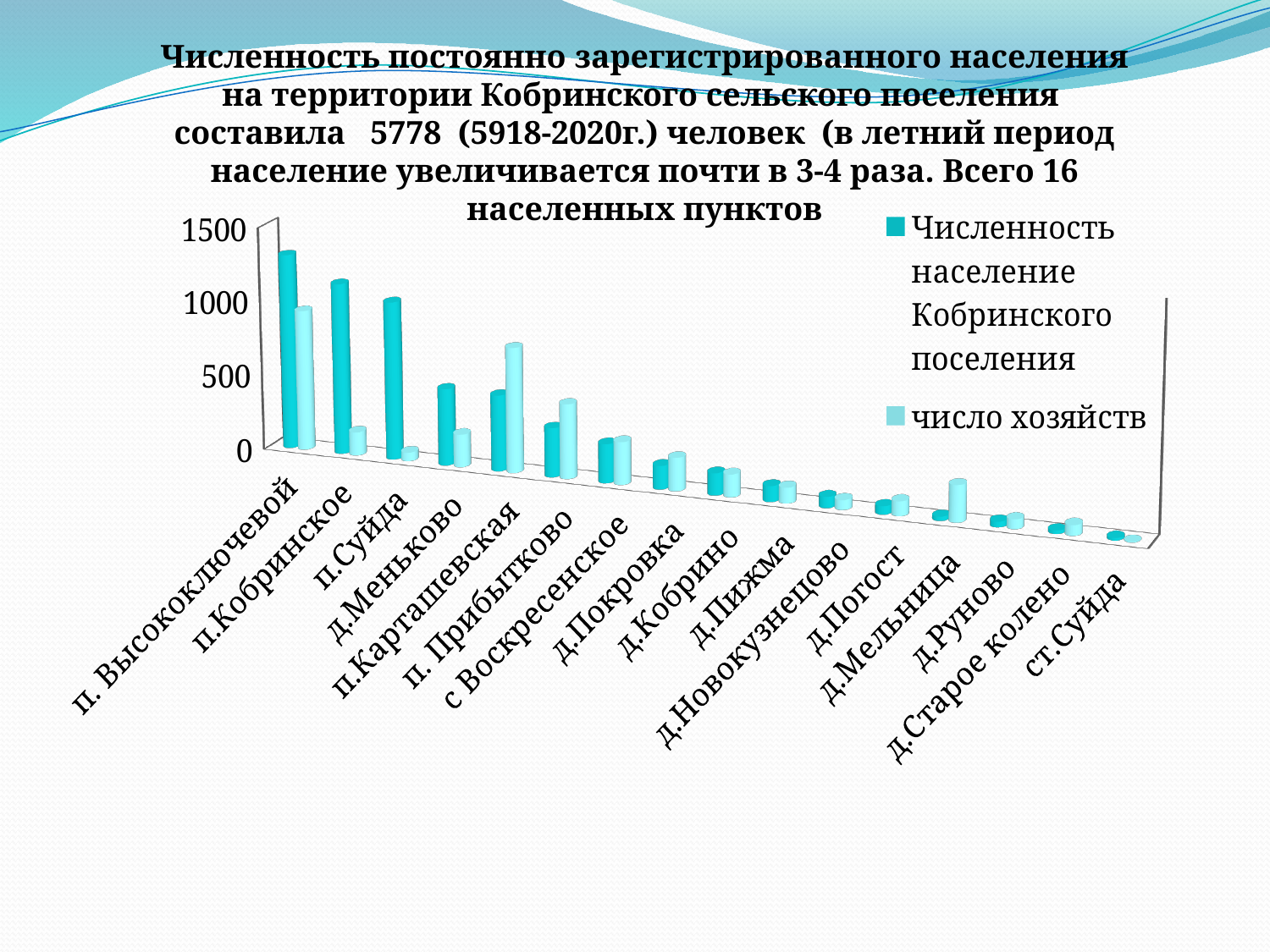
For п.Карташевская, which is larger: Численность население Кобринского поселения or число хозяйств? число хозяйств Which settlement has the highest value for число хозяйств? п. Высокоключевой Do the values of Численность население Кобринского поселения generally rise or fall from left to right along the x axis? fall Is the value of число хозяйств for п.Карташевская greater or less than 500? greater Which settlement has the highest value for Численность население Кобринского поселения? п. Высокоключевой How many series does the chart legend list? 2 What kind of chart is shown on the slide? bar chart Is the value of Численность население Кобринского поселения for п. Высокоключевой greater or less than 1000? greater How many settlements (categories) are shown on the x axis of the chart? 16 Which settlement has the lowest value for Численность население Кобринского поселения? ст.Суйда What is the second entry listed in the chart legend? число хозяйств